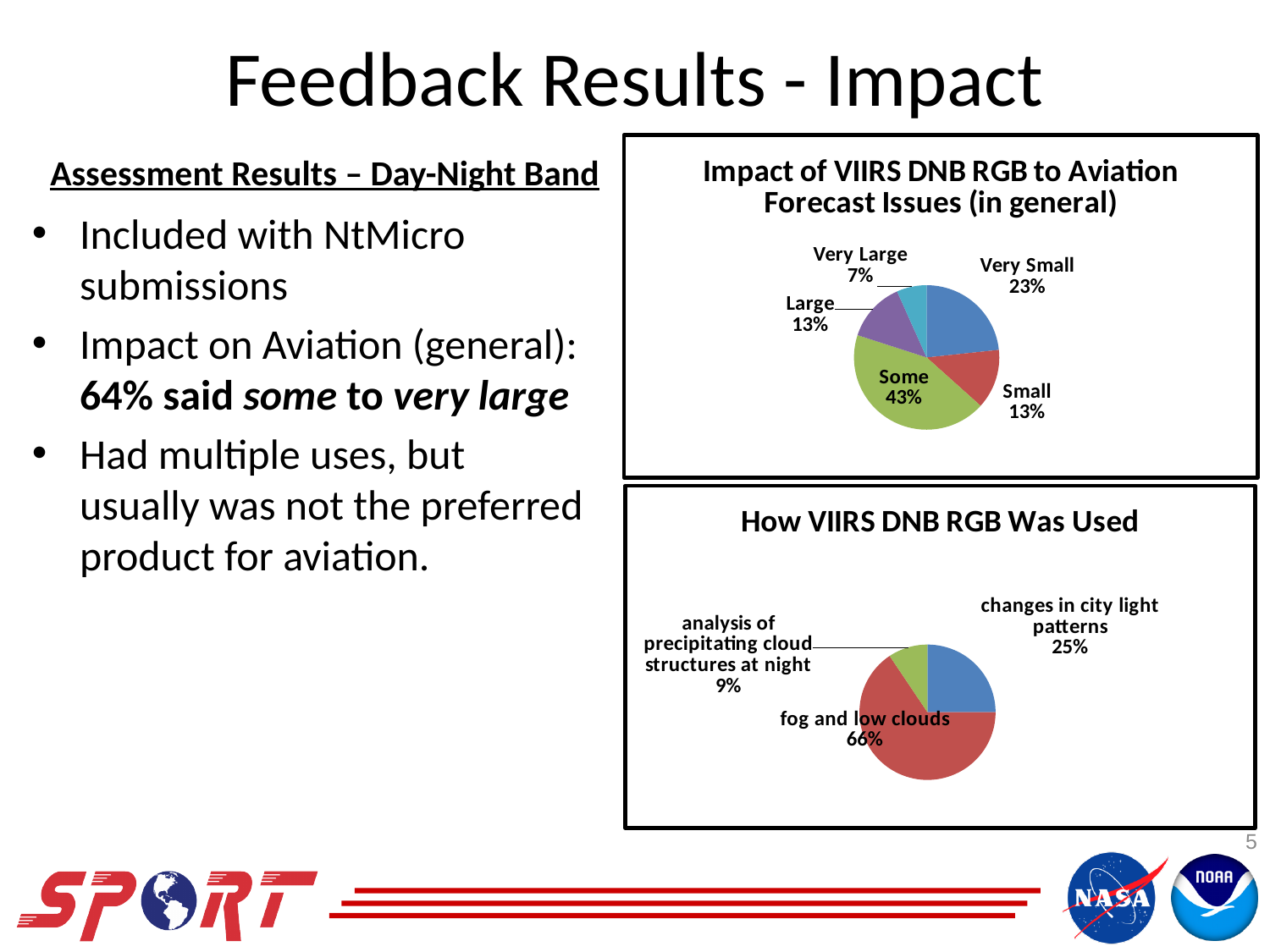
In the 'Impact of VIIRS DNB RGB to Aviation Forecast Issues (in general)' chart, how many categories are shown? 5 In the 'Impact of VIIRS DNB RGB to Aviation Forecast Issues (in general)' chart, which is larger, 'Very Small' or 'Small'? Very Small In the 'Impact of VIIRS DNB RGB to Aviation Forecast Issues (in general)' chart, what is the difference between the 'Very Small' and 'Large' shares? 10% In the 'Impact of VIIRS DNB RGB to Aviation Forecast Issues (in general)' chart, what share of responses is 'Very Large'? 7% In the 'How VIIRS DNB RGB Was Used' chart, what share is 'fog and low clouds'? 66% What kind of chart is 'How VIIRS DNB RGB Was Used'? Pie chart In the 'Impact of VIIRS DNB RGB to Aviation Forecast Issues (in general)' chart, what share of responses is 'Some'? 43% In the 'Impact of VIIRS DNB RGB to Aviation Forecast Issues (in general)' chart, which category has the largest share? Some In the 'How VIIRS DNB RGB Was Used' chart, what share is 'changes in city light patterns'? 25% In the 'Impact of VIIRS DNB RGB to Aviation Forecast Issues (in general)' chart, which category has the smallest share? Very Large In the 'How VIIRS DNB RGB Was Used' chart, how many categories are shown? 3 In the 'How VIIRS DNB RGB Was Used' chart, which category has the smallest share? analysis of precipitating cloud structures at night